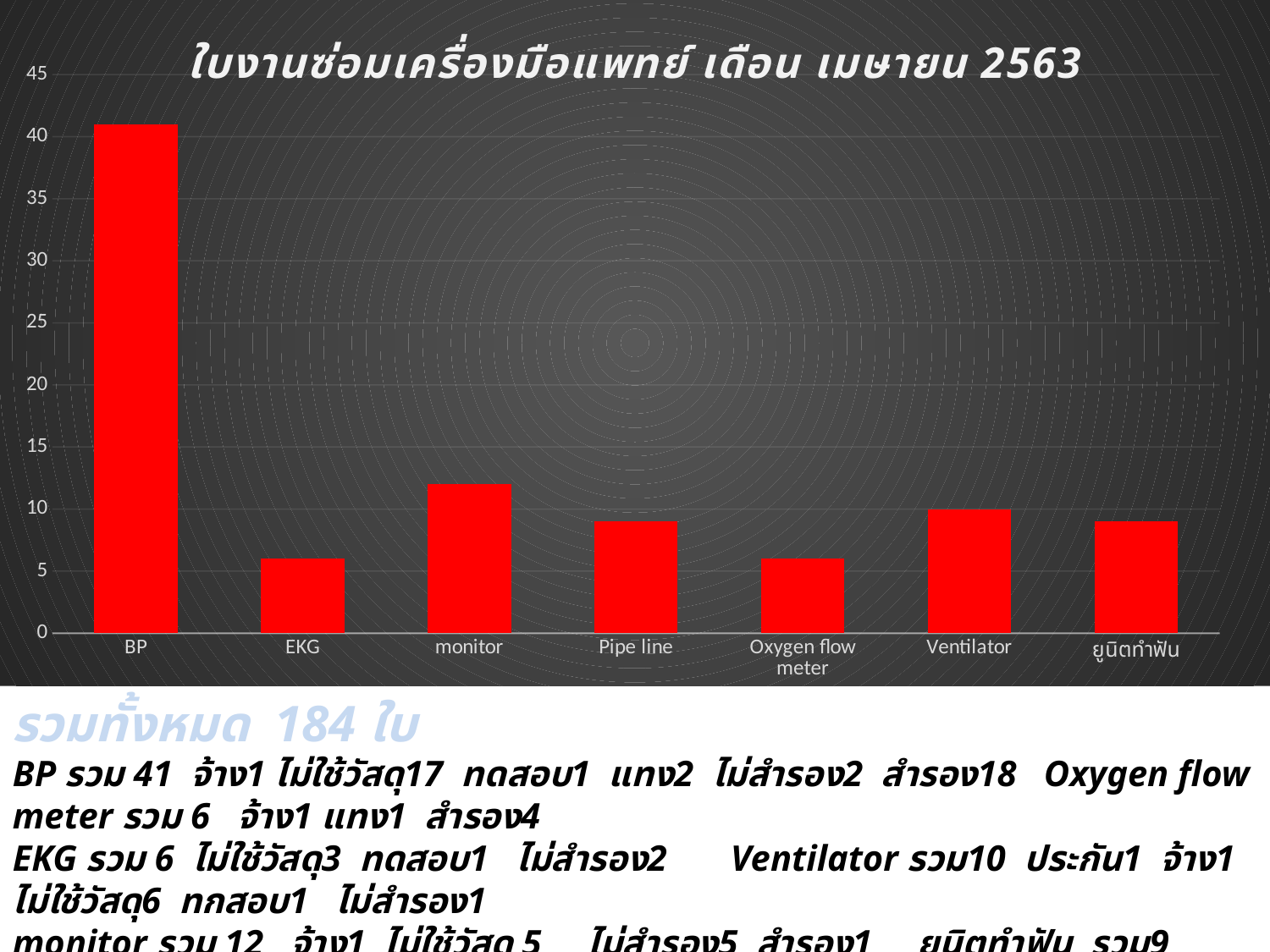
What colour are the bars in the chart? red Is the value for Pipe line greater or less than 10? less Is the value for EKG greater or less than 10? less Is the value for BP greater or less than 40? greater What is the title of the chart? ใบงานซ่อมเครื่องมือแพทย์ เดือน เมษายน 2563 According to the text below the chart, what is the total for BP (BP รวม)? 41 What kind of chart is shown on the slide? bar chart Which is larger, the value for Ventilator or the value for EKG? Ventilator Which is larger, the value for monitor or the value for Pipe line? monitor Which category has the highest bar in the chart? BP How many categories are shown on the x axis of the chart? 7